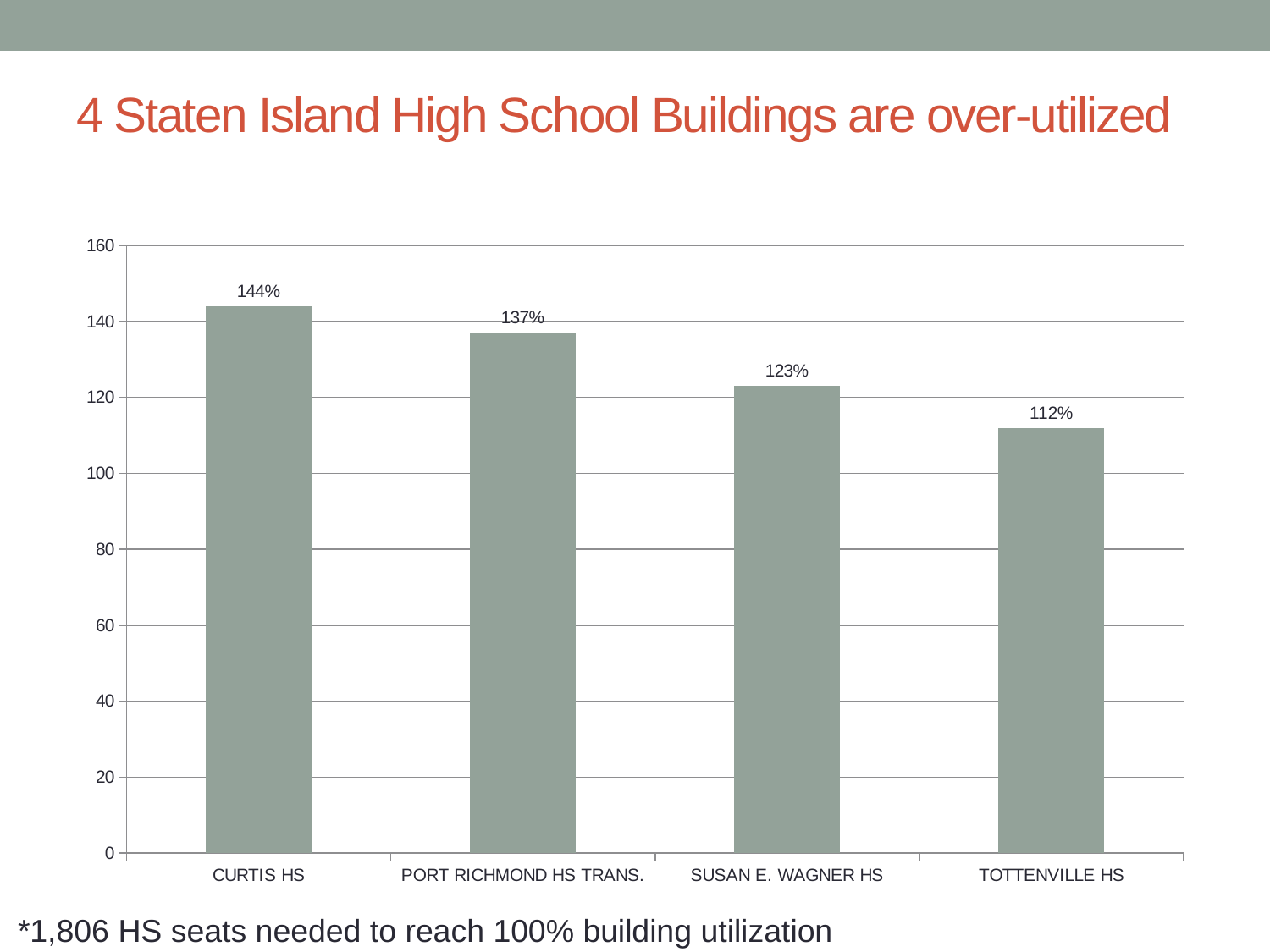
How many schools are shown in the chart? 4 Which school has the lowest utilization? TOTTENVILLE HS What is the utilization value for PORT RICHMOND HS TRANS.? 137% Do the values rise or fall from left to right across the schools? fall Which school has the highest utilization? CURTIS HS What is the utilization value for CURTIS HS? 144% What is the utilization value for TOTTENVILLE HS? 112% Is the value for SUSAN E. WAGNER HS greater or less than 120? greater Which is larger, the value for PORT RICHMOND HS TRANS. or SUSAN E. WAGNER HS? PORT RICHMOND HS TRANS. What is the difference between the values for CURTIS HS and TOTTENVILLE HS? 32% What is the utilization value for SUSAN E. WAGNER HS? 123% What kind of chart is shown on the slide? bar chart